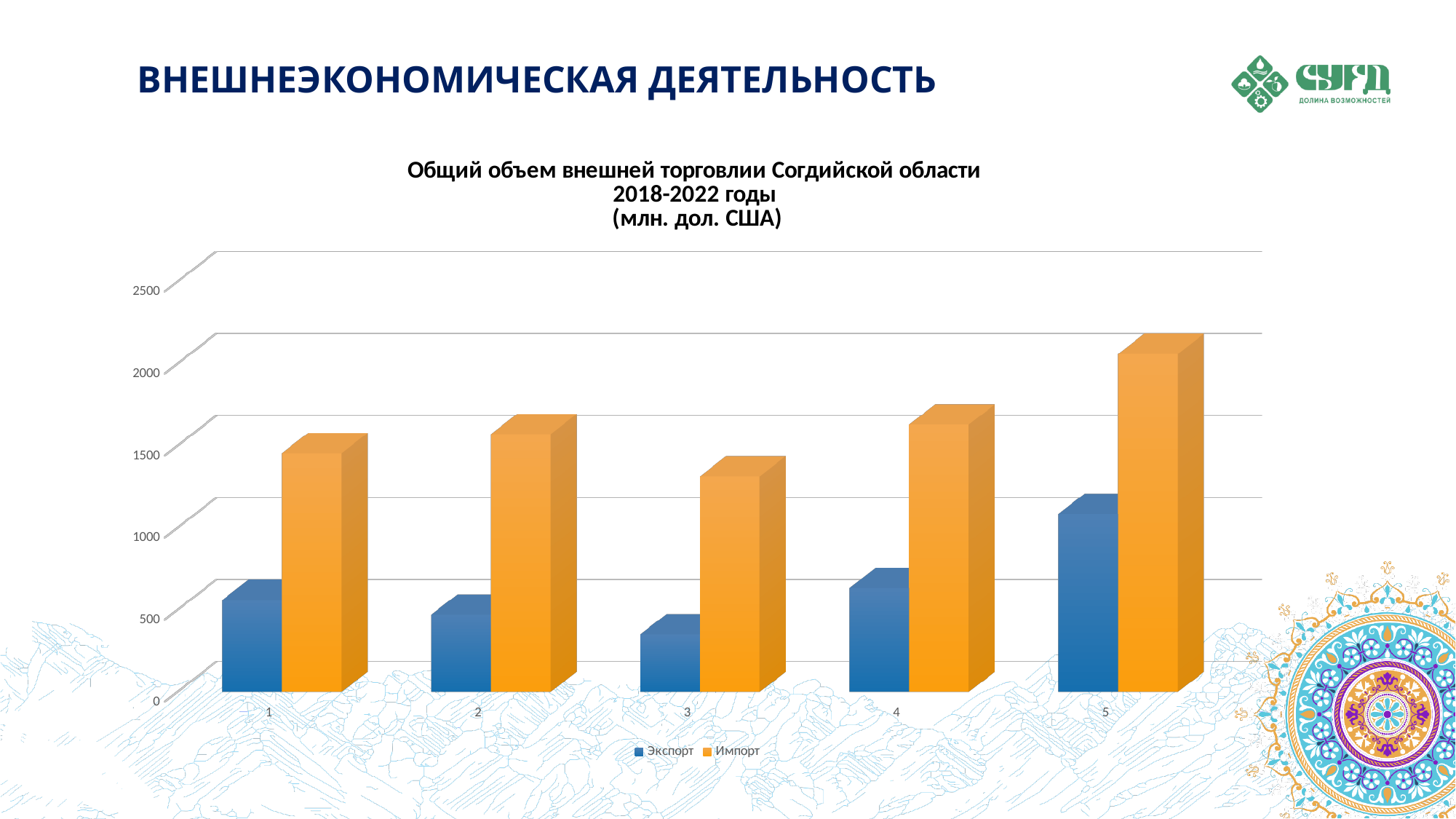
Which category has the lowest Экспорт value? 3 How many categories are shown on the x axis of the chart? 5 What unit is given in the chart title? млн. дол. США Is the Импорт value for category 3 greater or less than 1500? less Which category has the highest Импорт value? 5 Which category has the highest Экспорт value? 5 Is the Экспорт value for category 5 greater or less than 1000? greater How many series does the chart legend list? 2 Which series are listed in the chart legend? Экспорт, Импорт Which category has the lowest Импорт value? 3 In category 1, which is larger, Экспорт or Импорт? Импорт What kind of chart is shown on the slide? bar chart